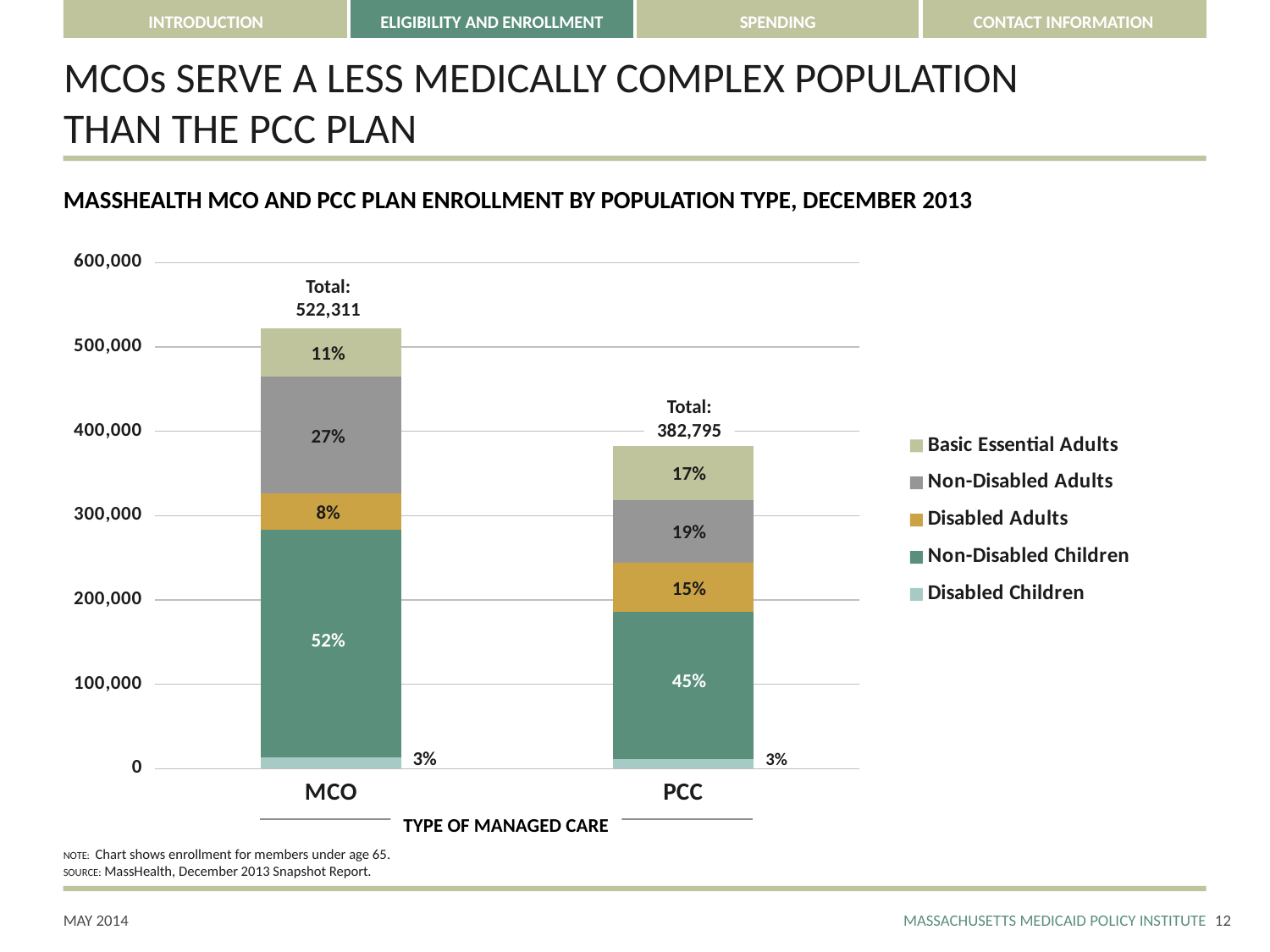
How many categories are shown on the x axis? 2 What percentage of MCO enrollment is Non-Disabled Children? 52% What kind of chart is shown on the slide? Stacked bar chart What is the difference in total enrollment between MCO and PCC? 139,516 How many series does the legend list? 5 Which type of managed care has the higher total enrollment, MCO or PCC? MCO What percentage of PCC enrollment is Basic Essential Adults? 17% What is the total enrollment shown for the PCC bar? 382,795 What percentage of MCO enrollment is Non-Disabled Adults? 27% What is the total enrollment shown for the MCO bar? 522,311 What percentage of PCC enrollment is Disabled Adults? 15% Is the total enrollment for PCC greater or less than 400,000? less